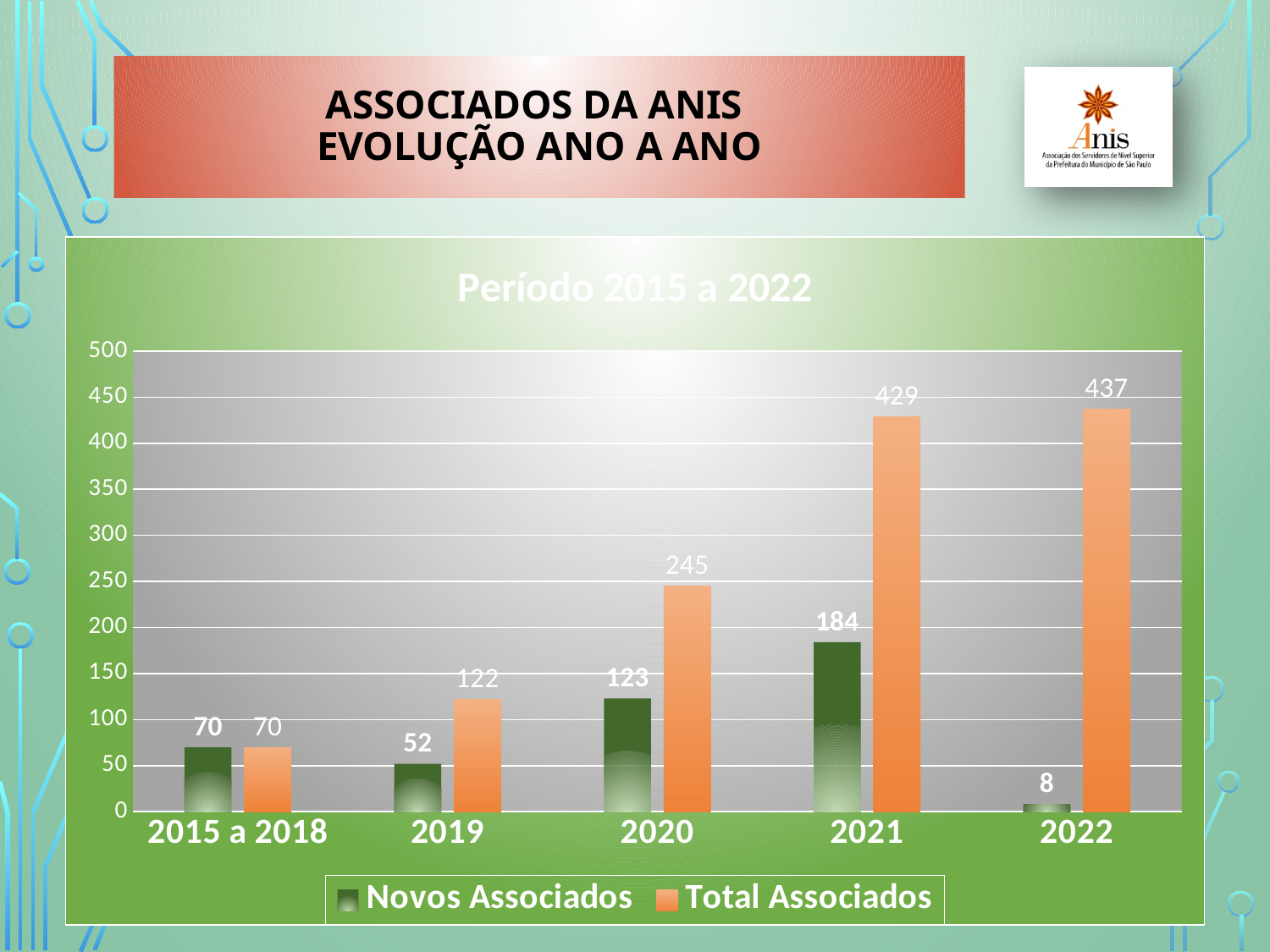
What kind of chart is shown on the slide? Bar chart How many categories are shown on the x axis? 5 What is the difference between Total Associados in 2021 and Total Associados in 2020? 184 Which is larger: Novos Associados in 2019 or Novos Associados in 2020? Novos Associados in 2020 What is the value of Total Associados for 2020? 245 Which category has the lowest value for Novos Associados? 2022 How many series does the legend list? 2 What is the value of Novos Associados for 2022? 8 Is the value of Total Associados for 2022 greater or less than 400? greater What is the value of Novos Associados for 2021? 184 What is the title of the chart? Período 2015 a 2022 Which category has the highest value for Total Associados? 2022